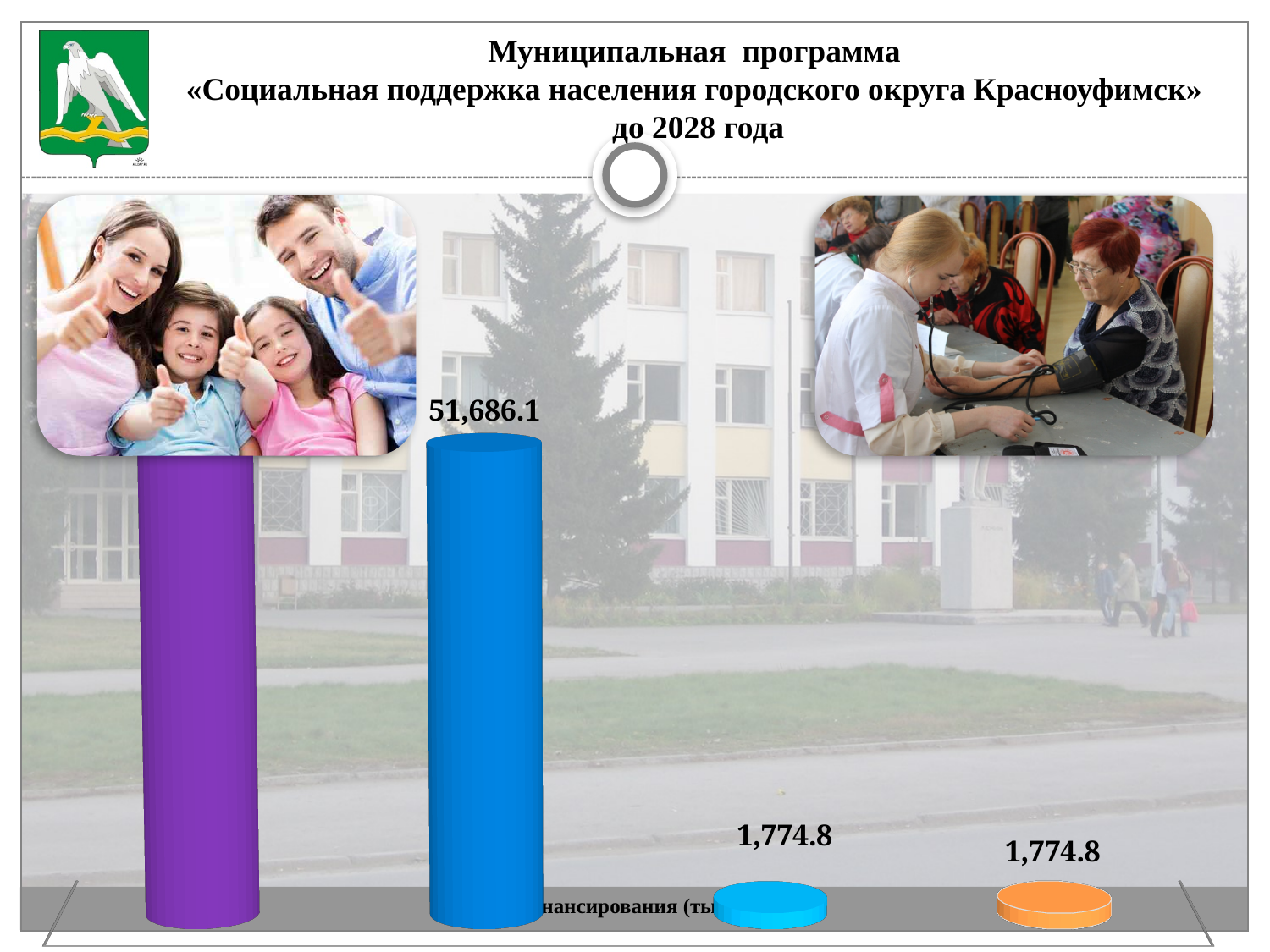
How many bars are plotted in the chart? 4 What is the difference between the blue bar (51,686.1) and the orange bar (1,774.8)? 49,911.3 Do the light blue bar and the orange bar have the same labelled value? yes What kind of chart is shown on the slide? bar chart What value is labelled on the light blue bar (third from the left)? 1,774.8 What value is labelled on the blue bar (second from the left)? 51,686.1 What colour is the bar labelled 51,686.1? blue Which is larger, the value of the blue bar (51,686.1) or the orange bar (1,774.8)? the blue bar What value is labelled on the orange bar (rightmost)? 1,774.8 What colour is the leftmost bar in the chart? purple